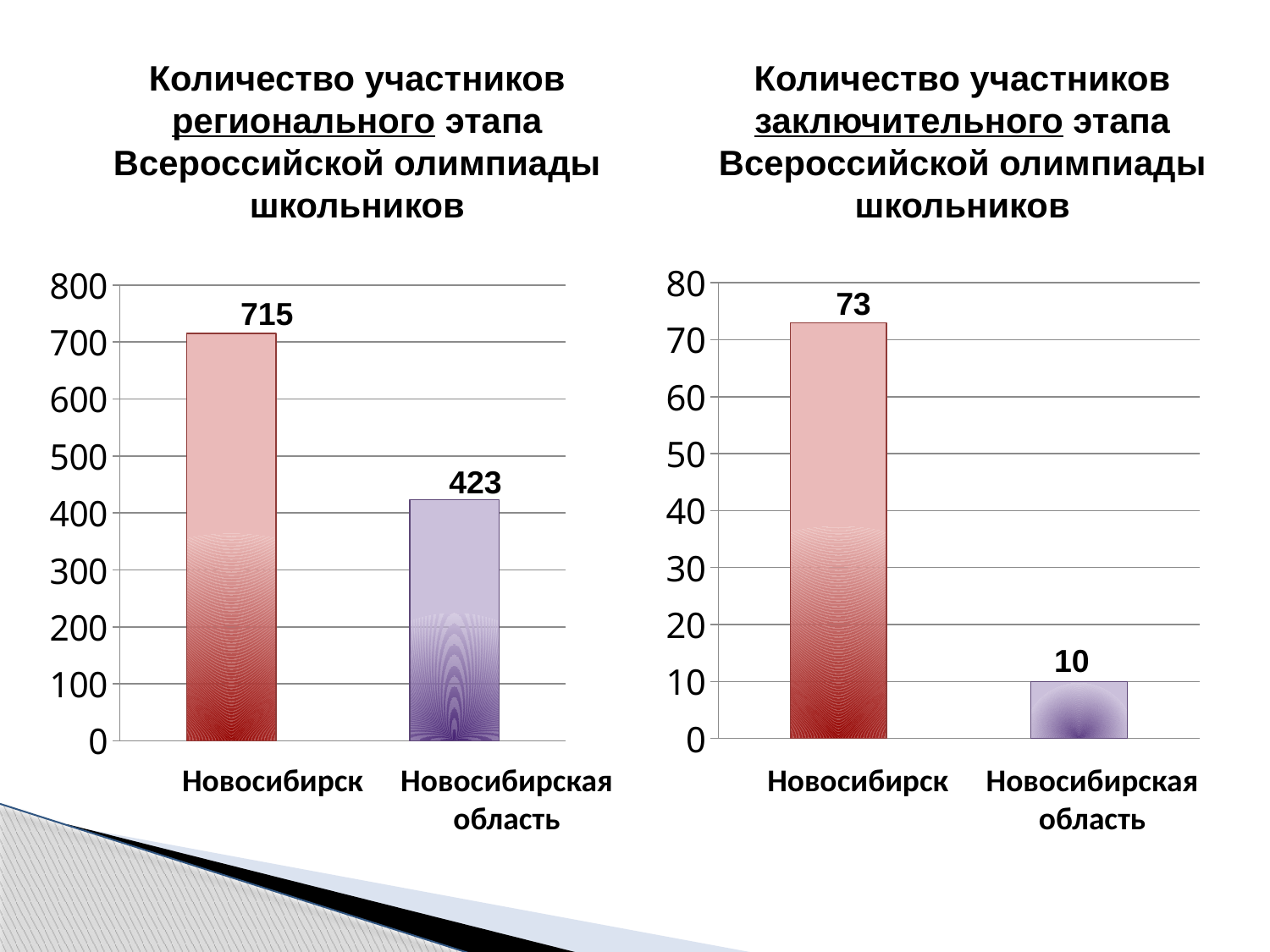
What kind of chart is the left chart (regional stage)? bar chart In the left chart (regional stage), what is the value for Новосибирск? 715 In the right chart (final stage), what is the value for Новосибирская область? 10 In the left chart (regional stage), is the value for Новосибирская область greater or less than 500? less How many categories are shown in the right chart (final stage)? 2 In the right chart (final stage), which is larger: the value for Новосибирск or for Новосибирская область? Новосибирск In the right chart (final stage), what is the value for Новосибирск? 73 In the right chart (final stage), which category has the lowest value? Новосибирская область In the left chart (regional stage), what is the difference between the values for Новосибирск and Новосибирская область? 292 In the left chart (regional stage), which category has the highest value? Новосибирск In the right chart (final stage), what is the difference between the values for Новосибирск and Новосибирская область? 63 In the left chart (regional stage), what is the value for Новосибирская область? 423